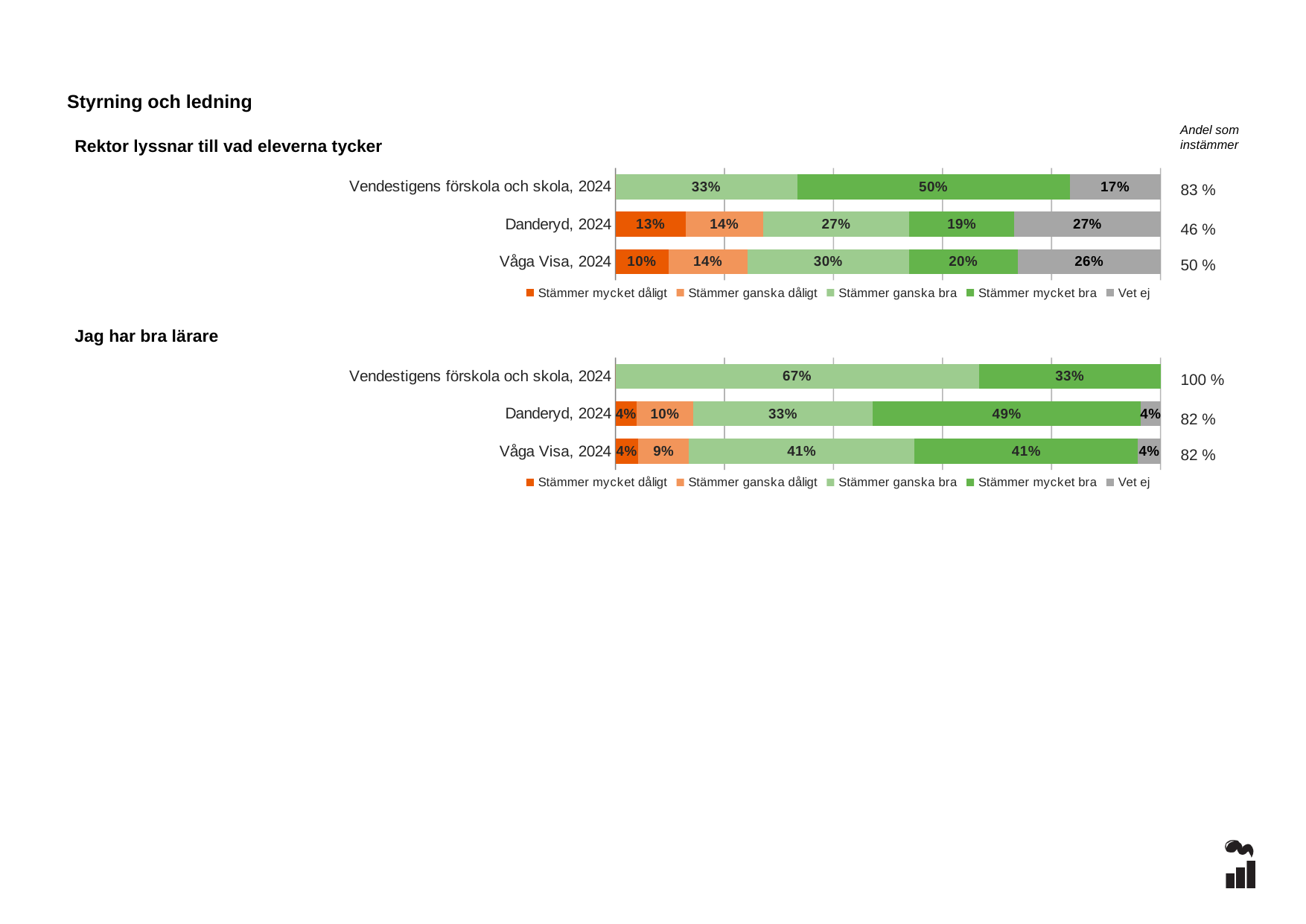
In the chart 'Rektor lyssnar till vad eleverna tycker', what is the 'Stämmer mycket dåligt' value for Danderyd, 2024? 13% How many categories are shown in the chart 'Rektor lyssnar till vad eleverna tycker'? 3 In the chart 'Rektor lyssnar till vad eleverna tycker', what is the difference between the 'Stämmer ganska bra' values for Våga Visa, 2024 and Danderyd, 2024? 3% In the chart 'Jag har bra lärare', which is larger: the 'Stämmer mycket bra' value for Danderyd, 2024 or for Våga Visa, 2024? Danderyd, 2024 In the chart 'Jag har bra lärare', what is the 'Andel som instämmer' value for Vendestigens förskola och skola, 2024? 100 % How many series does the legend of the chart 'Jag har bra lärare' list? 5 What kind of chart is 'Jag har bra lärare'? Stacked bar chart In the chart 'Rektor lyssnar till vad eleverna tycker', which category has the highest 'Stämmer mycket bra' value? Vendestigens förskola och skola, 2024 In the chart 'Jag har bra lärare', what is the 'Stämmer ganska bra' value for Vendestigens förskola och skola, 2024? 67% In the chart 'Jag har bra lärare', what is the 'Stämmer mycket bra' value for Danderyd, 2024? 49% In the chart 'Rektor lyssnar till vad eleverna tycker', what is the 'Vet ej' value for Våga Visa, 2024? 26% In the chart 'Rektor lyssnar till vad eleverna tycker', what is the 'Stämmer mycket bra' value for Vendestigens förskola och skola, 2024? 50%